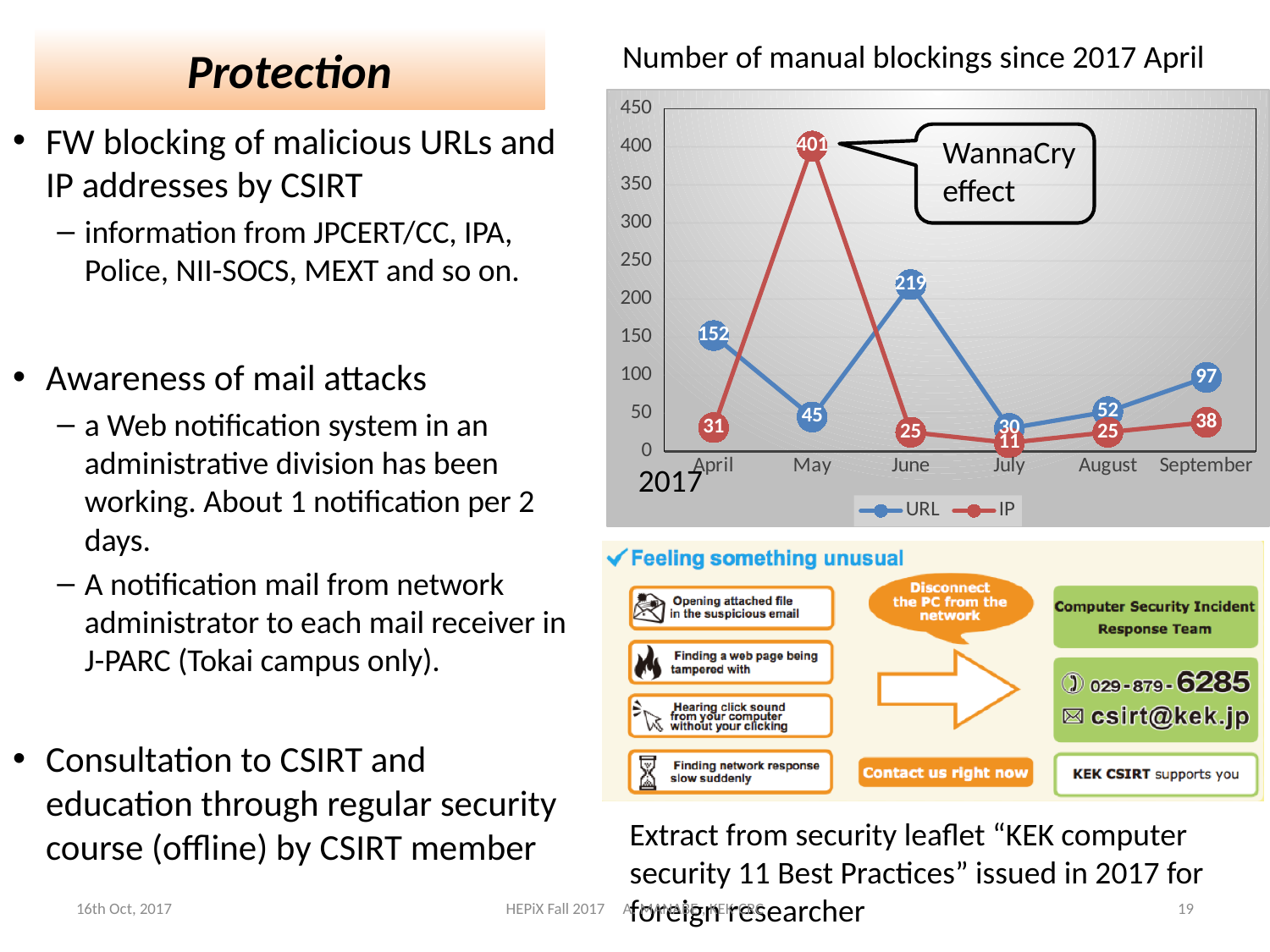
In which month is the IP series highest in the 'Number of manual blockings since 2017 April' chart? May In which month is the URL series lowest in the 'Number of manual blockings since 2017 April' chart? July What is the IP value for May in the 'Number of manual blockings since 2017 April' chart? 401 What kind of chart is the 'Number of manual blockings since 2017 April' chart? Line chart How many series does the legend of the 'Number of manual blockings since 2017 April' chart list? 2 In the 'Number of manual blockings since 2017 April' chart, which is larger in May: the URL value or the IP value? IP What is the difference between the URL and IP values for April in the 'Number of manual blockings since 2017 April' chart? 121 What does the callout on the 'Number of manual blockings since 2017 April' chart attribute the May peak to? WannaCry effect Is the URL value for June greater or less than 200 in the 'Number of manual blockings since 2017 April' chart? greater How many months are plotted on the x axis of the 'Number of manual blockings since 2017 April' chart? 6 What is the URL value for September in the 'Number of manual blockings since 2017 April' chart? 97 What is the URL value for June in the 'Number of manual blockings since 2017 April' chart? 219